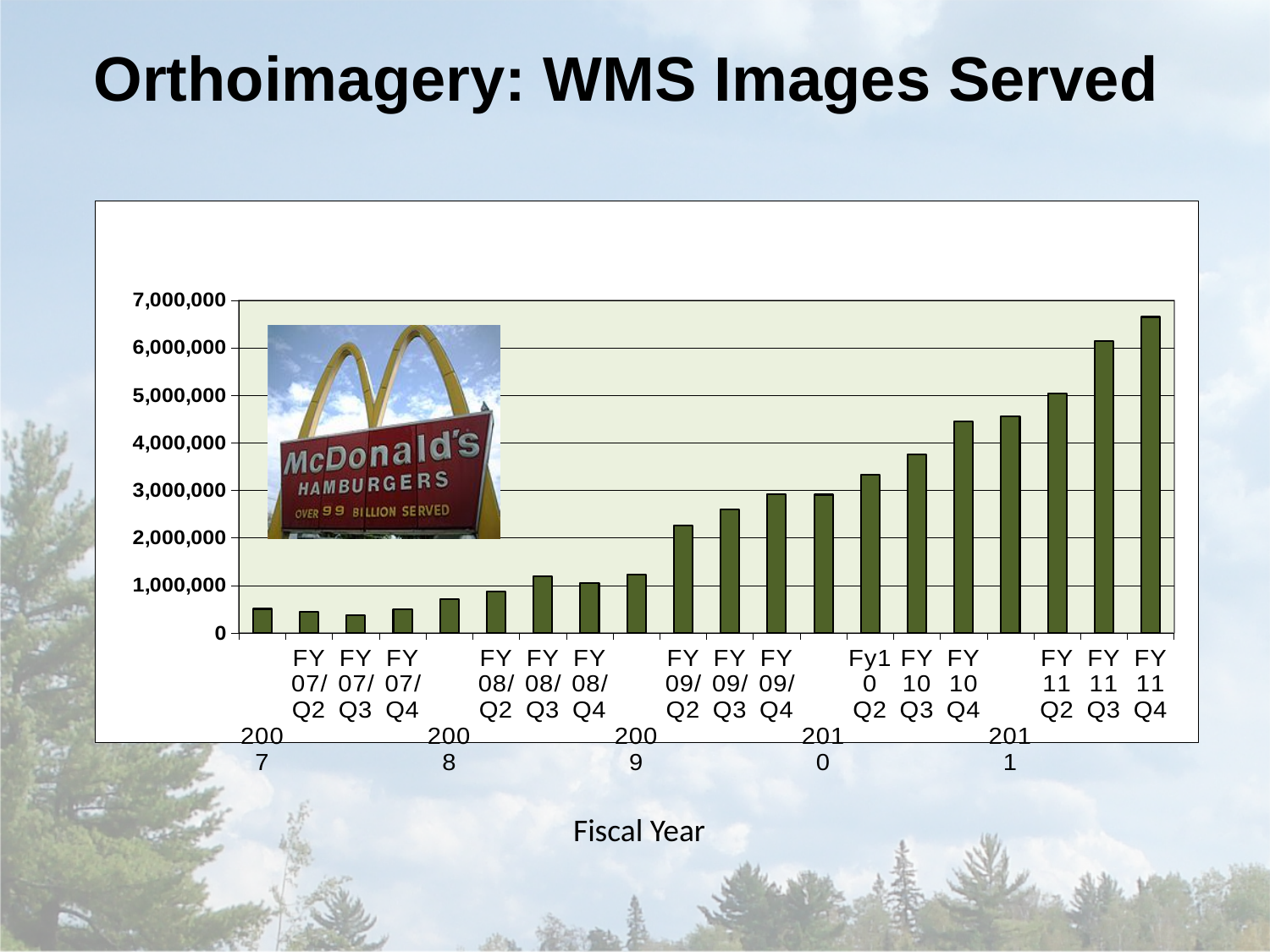
Do the values generally rise or fall from 2007 to FY 11 Q4 along the x axis? rise Is the value for FY 10 Q4 greater or less than 4,000,000? greater What is the highest tick value shown on the y axis? 7,000,000 Is the value for 2008 greater or less than 1,000,000? less Which is larger, the value for FY 10 Q4 or the value for FY 09/Q4? FY 10 Q4 Is the value for FY 11 Q4 greater or less than 6,000,000? greater Which category has the highest bar in the chart? FY 11 Q4 What is the x-axis title of the chart? Fiscal Year How many bars are plotted in the chart? 20 What kind of chart is shown on the slide? bar chart